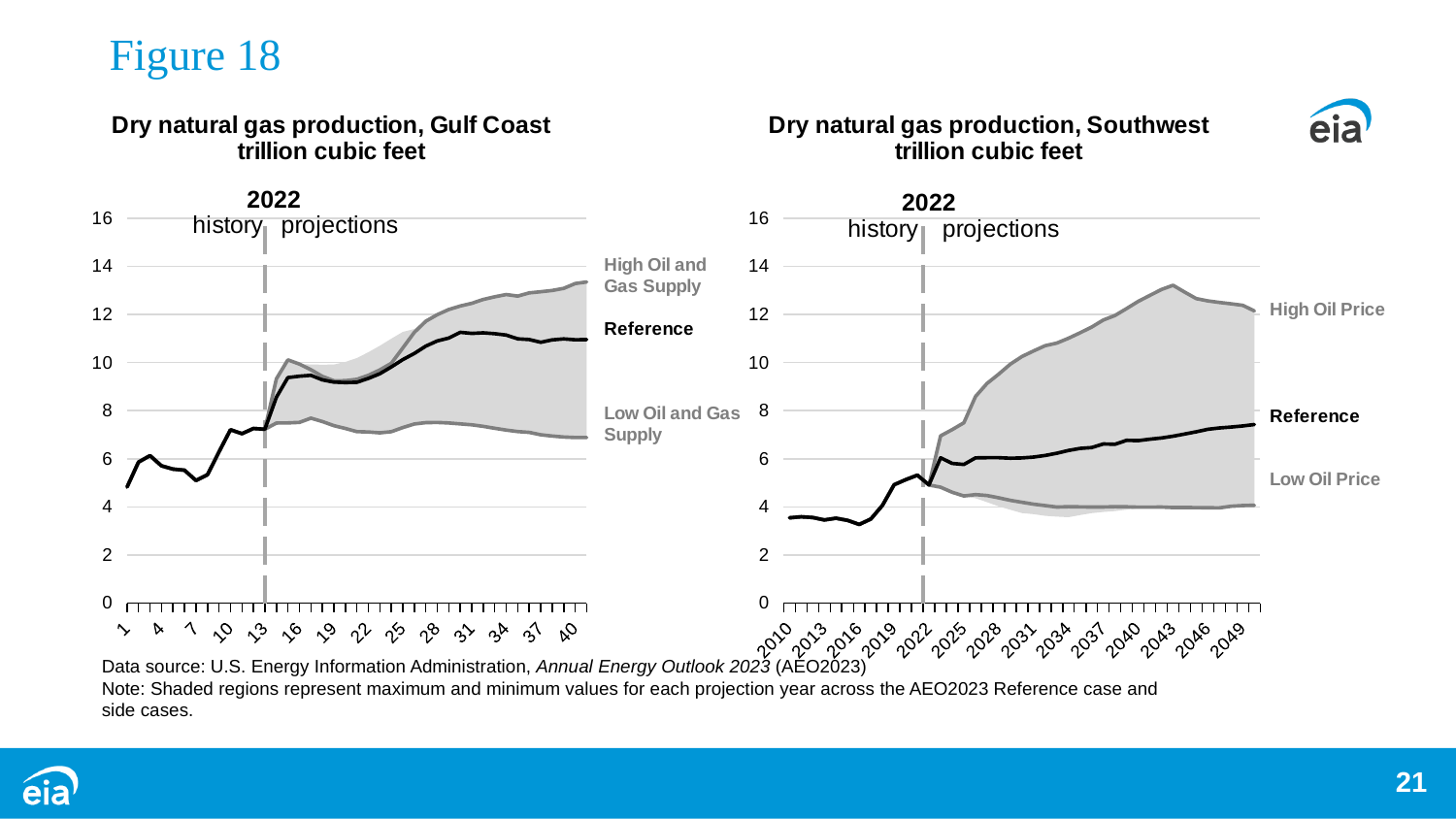
In the 'Dry natural gas production, Southwest' chart, is the Low Oil Price value in 2049 greater or less than 6? less In the 'Dry natural gas production, Southwest' chart, which is higher in 2049, High Oil Price or Low Oil Price? High Oil Price In the 'Dry natural gas production, Southwest' chart, is the value at the start of the history period (2010) greater or less than 4? less In the 'Dry natural gas production, Gulf Coast' chart, is the Low Oil and Gas Supply value at the end of the projection period greater or less than 8? less What unit of measurement is used in both charts on the slide? trillion cubic feet In the 'Dry natural gas production, Southwest' chart, does the Reference line rise or fall over the projection period from 2022 to 2049? rise What kind of chart is the 'Dry natural gas production, Gulf Coast' chart? line chart What year does the vertical dashed line separating history from projections mark in both charts? 2022 How many labeled projection lines are shown in the 'Dry natural gas production, Gulf Coast' chart? 3